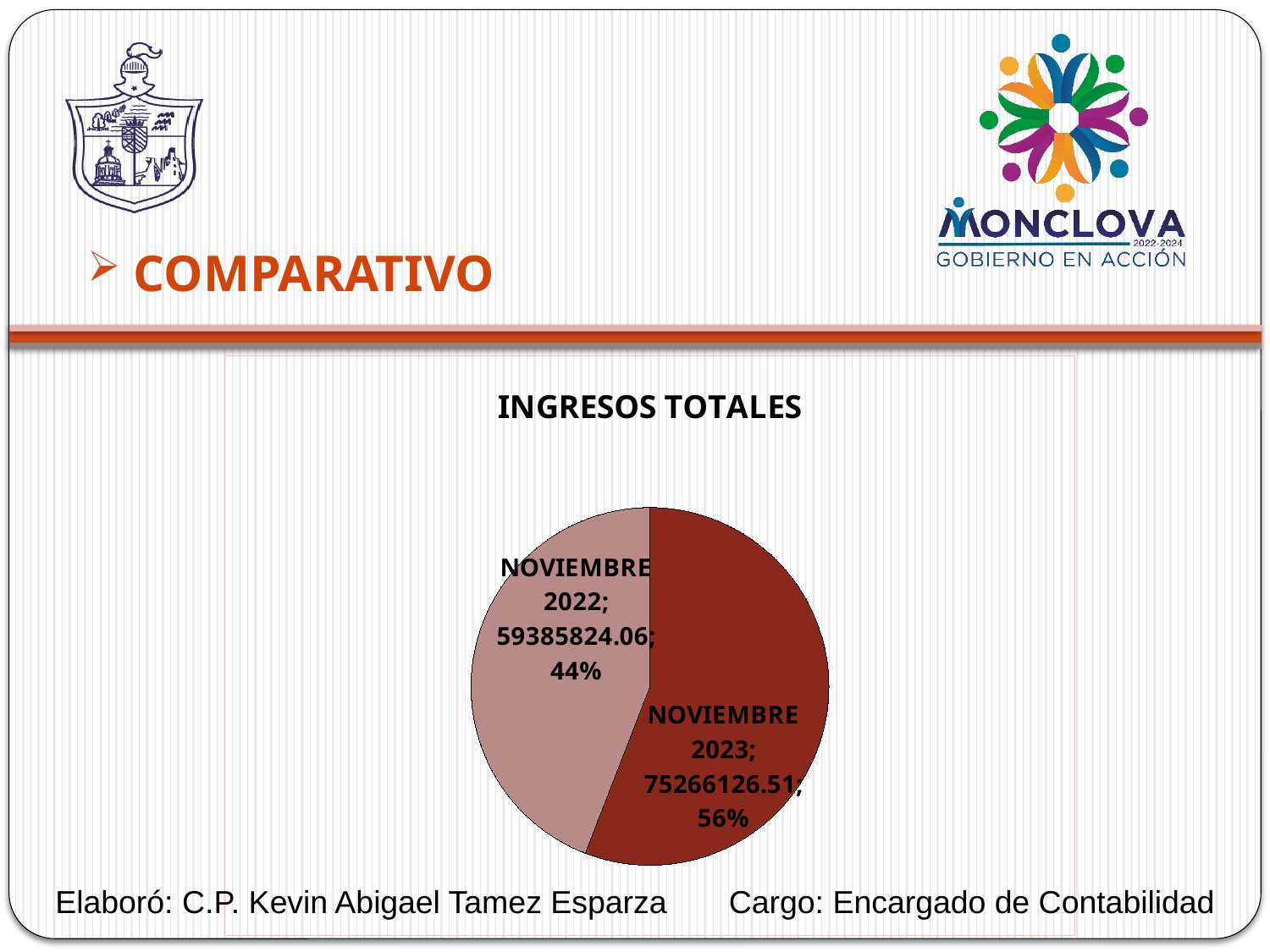
What share of the pie does NOVIEMBRE 2022 represent? 44% What kind of chart is shown on the slide? pie chart What is the value for NOVIEMBRE 2022? 59385824.06 Which slice is the smallest? NOVIEMBRE 2022 Which slice is the largest? NOVIEMBRE 2023 Which is larger, the value for NOVIEMBRE 2022 or NOVIEMBRE 2023? NOVIEMBRE 2023 What is the value for NOVIEMBRE 2023? 75266126.51 How many slices does the pie chart have? 2 What is the total of the two values shown in the pie chart? 134651950.57 What is the title of the chart? INGRESOS TOTALES What share of the pie does NOVIEMBRE 2023 represent? 56% What is the difference between the values for NOVIEMBRE 2023 and NOVIEMBRE 2022? 15880302.45